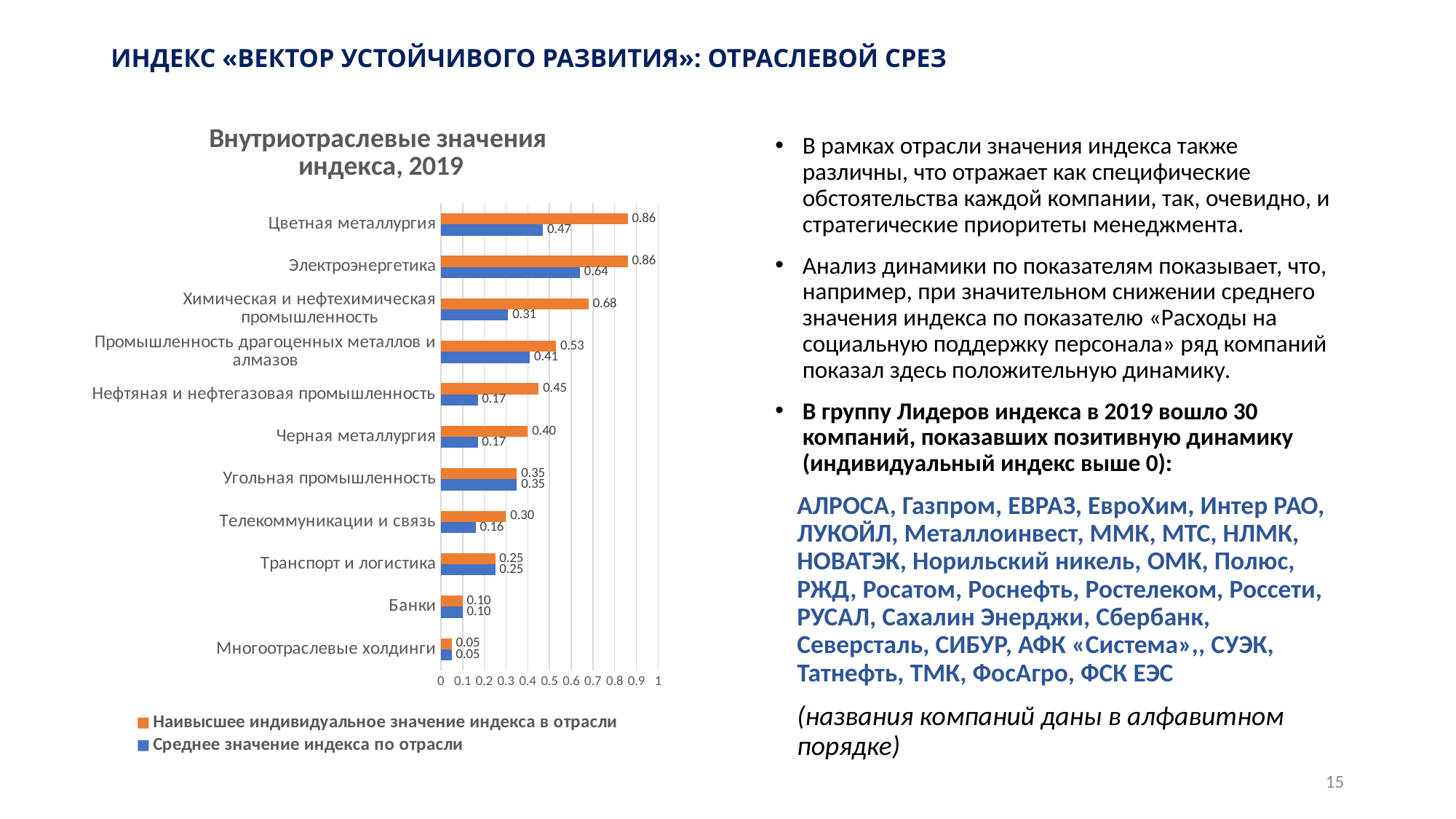
How many series does the legend list? 2 What is the difference between the highest individual value and the industry average for Химическая и нефтехимическая промышленность? 0.37 Which category has the lowest highest-individual index value? Многоотраслевые холдинги Which category has the highest industry average index value? Электроэнергетика How many industry categories are shown in the chart? 11 What is the industry average index value for Нефтяная и нефтегазовая промышленность? 0.17 What type of chart is shown on the slide? Bar chart What is the industry average index value (Среднее значение индекса по отрасли) for Электроэнергетика? 0.64 What is the highest individual index value (Наивысшее индивидуальное значение индекса в отрасли) for Цветная металлургия? 0.86 Which is larger: the industry average for Промышленность драгоценных металлов и алмазов or the industry average for Угольная промышленность? Промышленность драгоценных металлов и алмазов What is the title of the chart? Внутриотраслевые значения индекса, 2019 Which colour represents the series Среднее значение индекса по отрасли? Blue